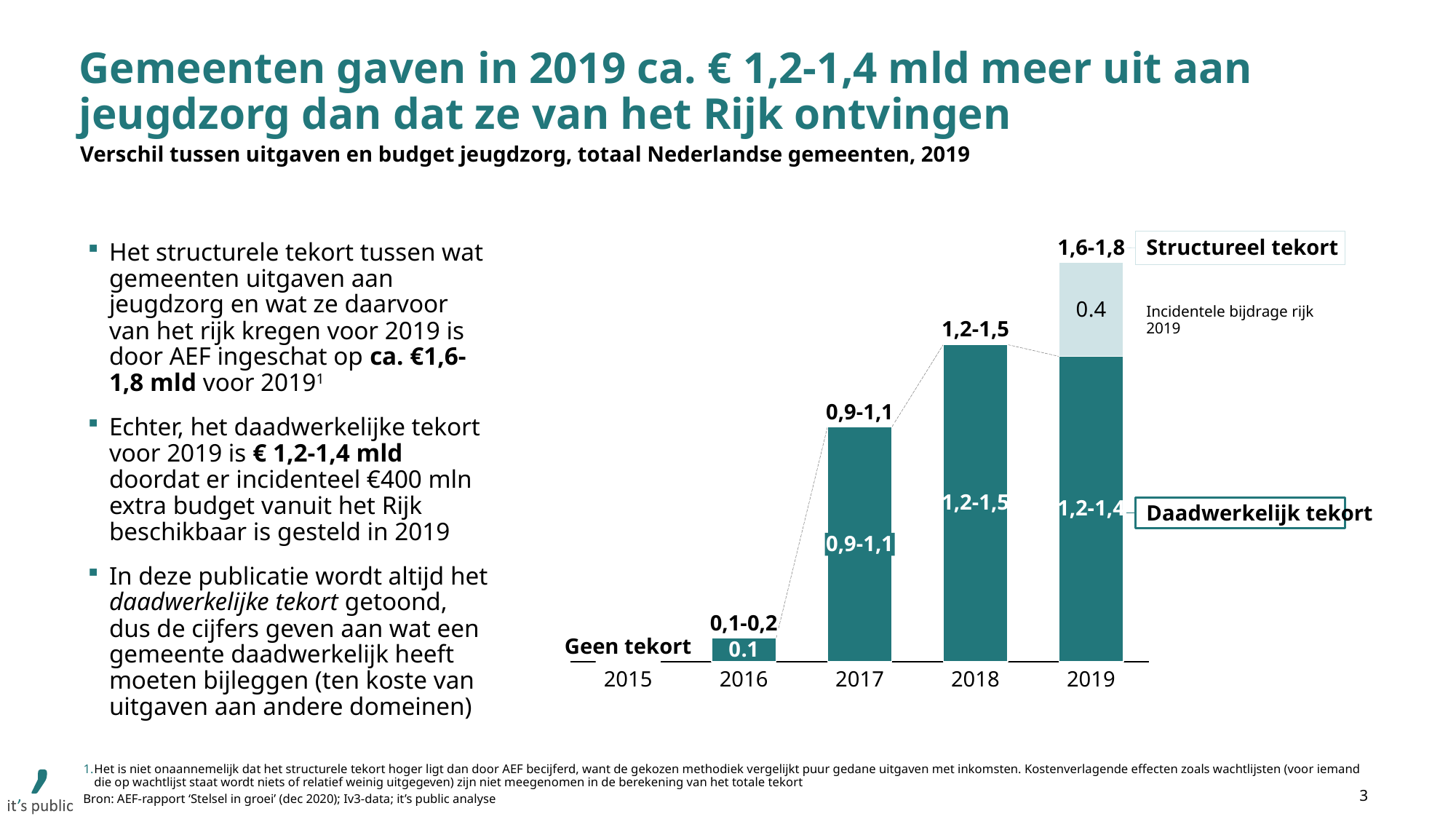
What is the total 'Structureel tekort' printed above the 2019 bar? 1,6-1,8 Which year has the lowest non-zero bar in the chart? 2016 What range is printed for 2018? 1,2-1,5 What value is printed inside the bar for 2016? 0.1 What kind of chart is shown on the slide? bar chart What value is printed in the light segment of the 2019 bar (Incidentele bijdrage rijk 2019)? 0.4 What is the 'Daadwerkelijk tekort' value printed in the dark segment of the 2019 bar? 1,2-1,4 What is the label shown for 2015 in the chart? Geen tekort Do the bar values rise or fall from 2015 to 2018? rise What range is printed above the bar for 2016? 0,1-0,2 How many years are shown on the x axis of the chart? 5 What range is printed for 2017? 0,9-1,1